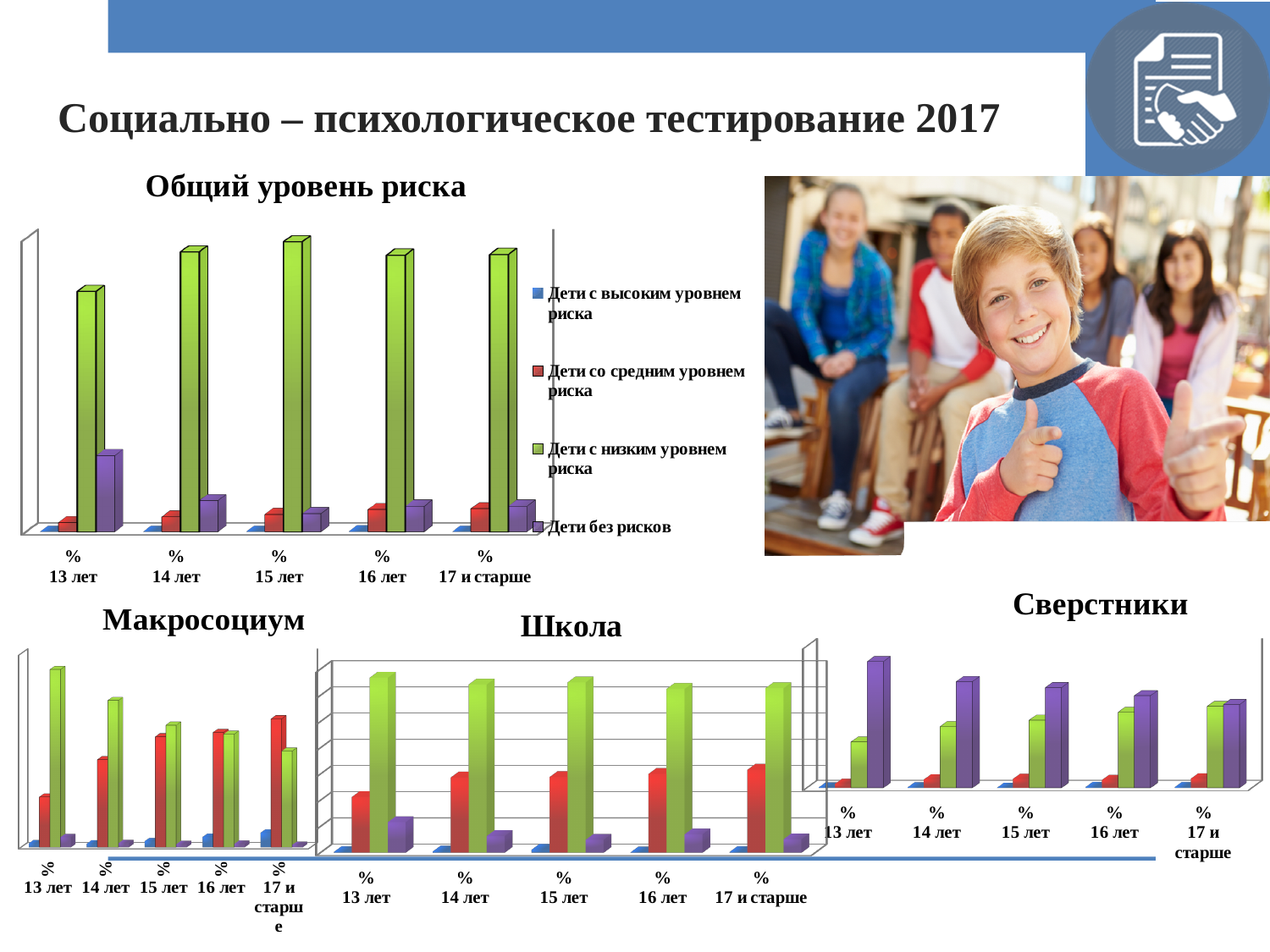
In the "Общий уровень риска" chart, which series has the tallest bar for 13 лет? Дети с низким уровнем риска In the "Общий уровень риска" chart, which series is shown in green according to the legend? Дети с низким уровнем риска In the "Школа" chart, for 13 лет, which is larger: "Дети со средним уровнем риска" or "Дети без рисков"? Дети со средним уровнем риска In the "Сверстники" chart, do the bars for "Дети с низким уровнем риска" rise or fall from 13 лет to 17 и старше? rise In the "Общий уровень риска" chart, which age group has the tallest bar for "Дети без рисков"? 13 лет How many age categories are shown on the x axis of the "Общий уровень риска" chart? 5 What kind of chart is the "Общий уровень риска" chart? bar chart In the "Сверстники" chart, which series has the tallest bar for 13 лет? Дети без рисков How many series does the legend of the "Общий уровень риска" chart list? 4 In the "Макросоциум" chart, do the bars for "Дети со средним уровнем риска" rise or fall from 13 лет to 17 и старше? rise In the "Сверстники" chart, do the bars for "Дети без рисков" rise or fall from 13 лет to 17 и старше? fall